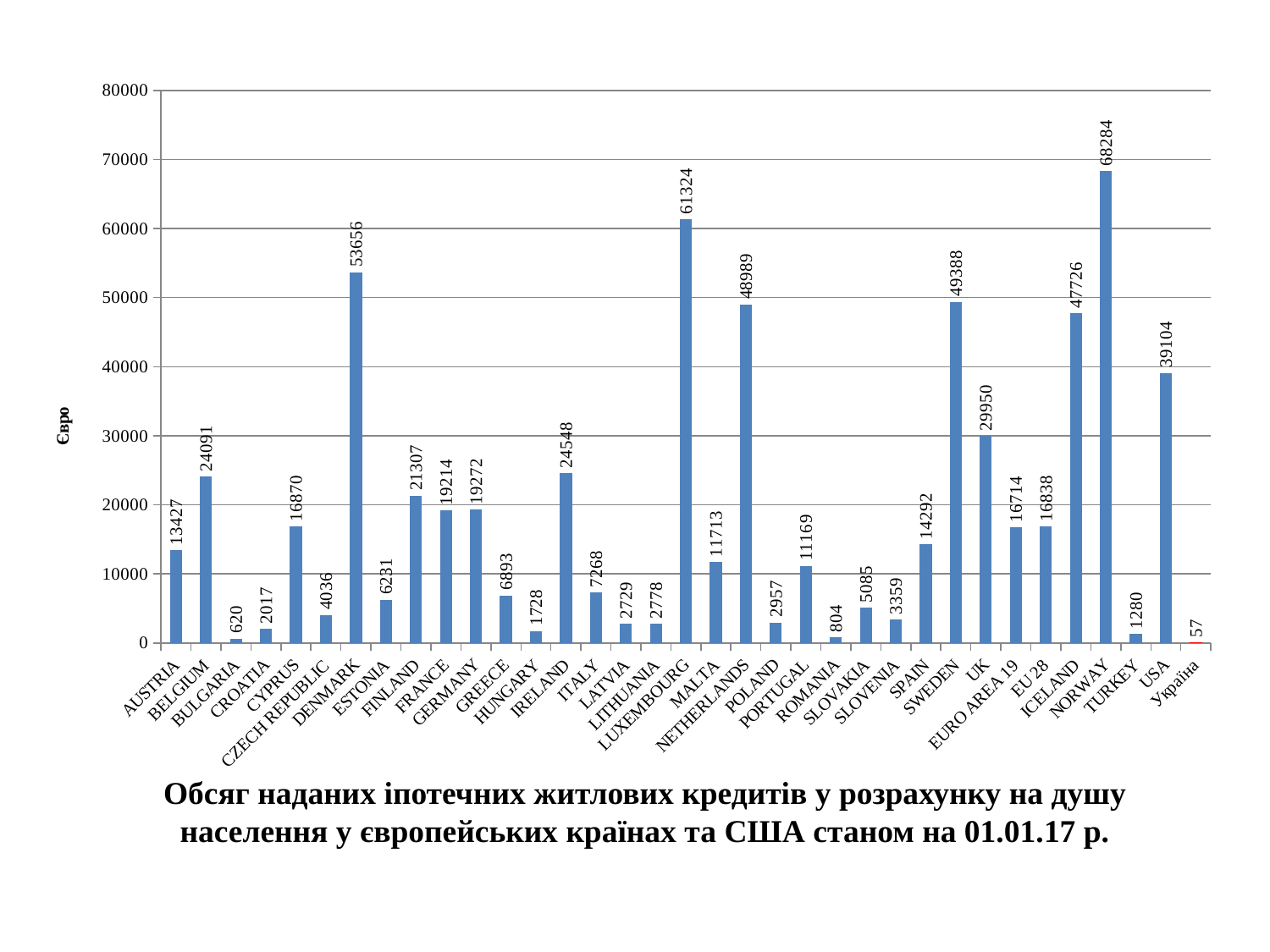
What is the label on the vertical axis? Євро Which category has the highest value? NORWAY What is the value for DENMARK? 53656 What is the value for Україна? 57 What is the difference between the values for NORWAY and LUXEMBOURG? 6960 Which category has the lowest value? Україна What kind of chart is shown on the slide? bar chart What is the difference between the values for BELGIUM and AUSTRIA? 10664 What is the value for LUXEMBOURG? 61324 How many categories are shown on the x axis? 35 What is the value for EU 28? 16838 Which is larger, the value for SWEDEN or the value for NETHERLANDS? SWEDEN